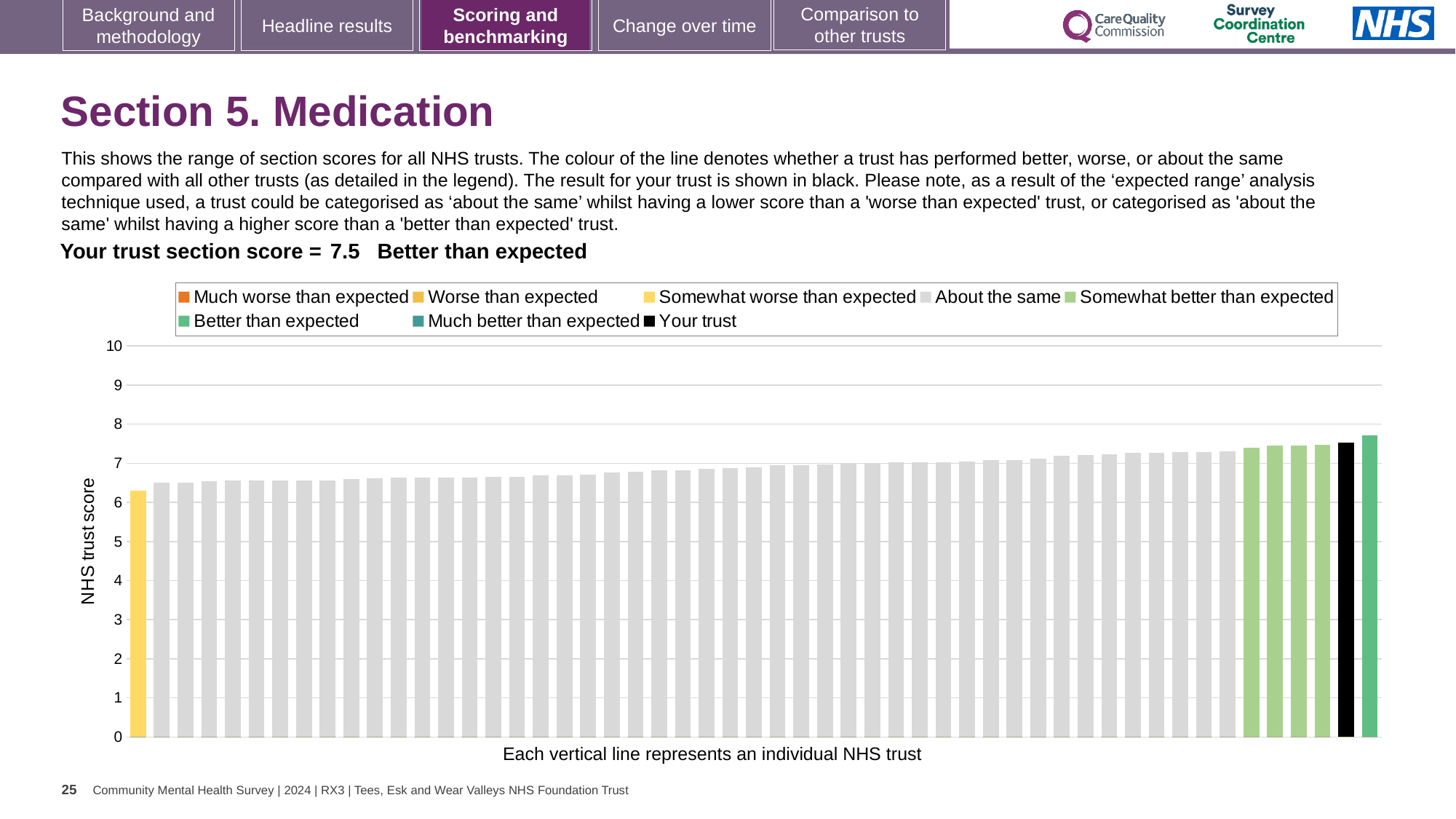
Is the value of the leftmost (yellow) bar greater or less than 7? less What is the label on the vertical axis of the chart? NHS trust score What kind of chart is shown on the slide? Bar chart How many entries does the chart legend list? 8 Which is larger: the value of the black bar (your trust) or the value of the leftmost yellow bar? The black bar (your trust) Is the black bar (your trust) the highest bar in the chart? No What is the section score for your trust shown on the slide? 7.5 Do the bar values rise or fall from left to right along the x axis? Rise What colour is used for the bar representing your trust? Black How is your trust's section score categorised compared with other trusts? Better than expected Is the value of the black bar (your trust) greater or less than 7? greater Is the value of the rightmost bar greater or less than 8? less